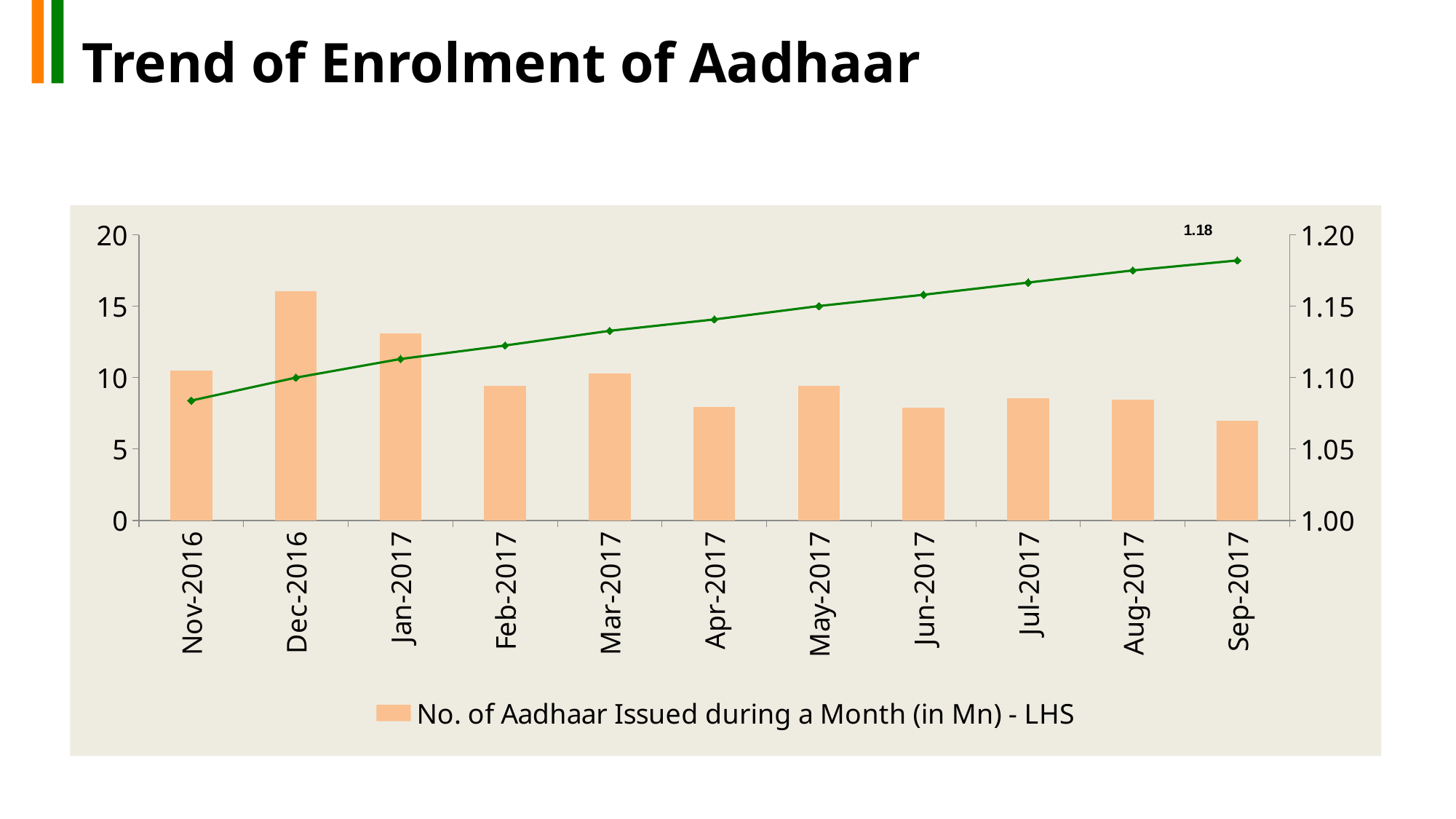
Does the green line rise or fall from Nov-2016 to Sep-2017? rises What kind of chart is shown on the slide? A bar chart combined with a line What value is printed as the data label on the green line at Sep-2017? 1.18 What is the legend entry for the bars? No. of Aadhaar Issued during a Month (in Mn) - LHS Which month has the larger number of Aadhaar issued, Dec-2016 or Jan-2017? Dec-2016 How many months are shown on the x axis of the chart? 11 Is the number of Aadhaar issued in Jan-2017 greater or less than 10? greater Is the number of Aadhaar issued in Dec-2016 greater or less than 15? greater How many series does the legend list? 1 Is the number of Aadhaar issued in Sep-2017 greater or less than 10? less Which month has the lowest number of Aadhaar issued during a month? Sep-2017 Which month has the highest number of Aadhaar issued during a month? Dec-2016